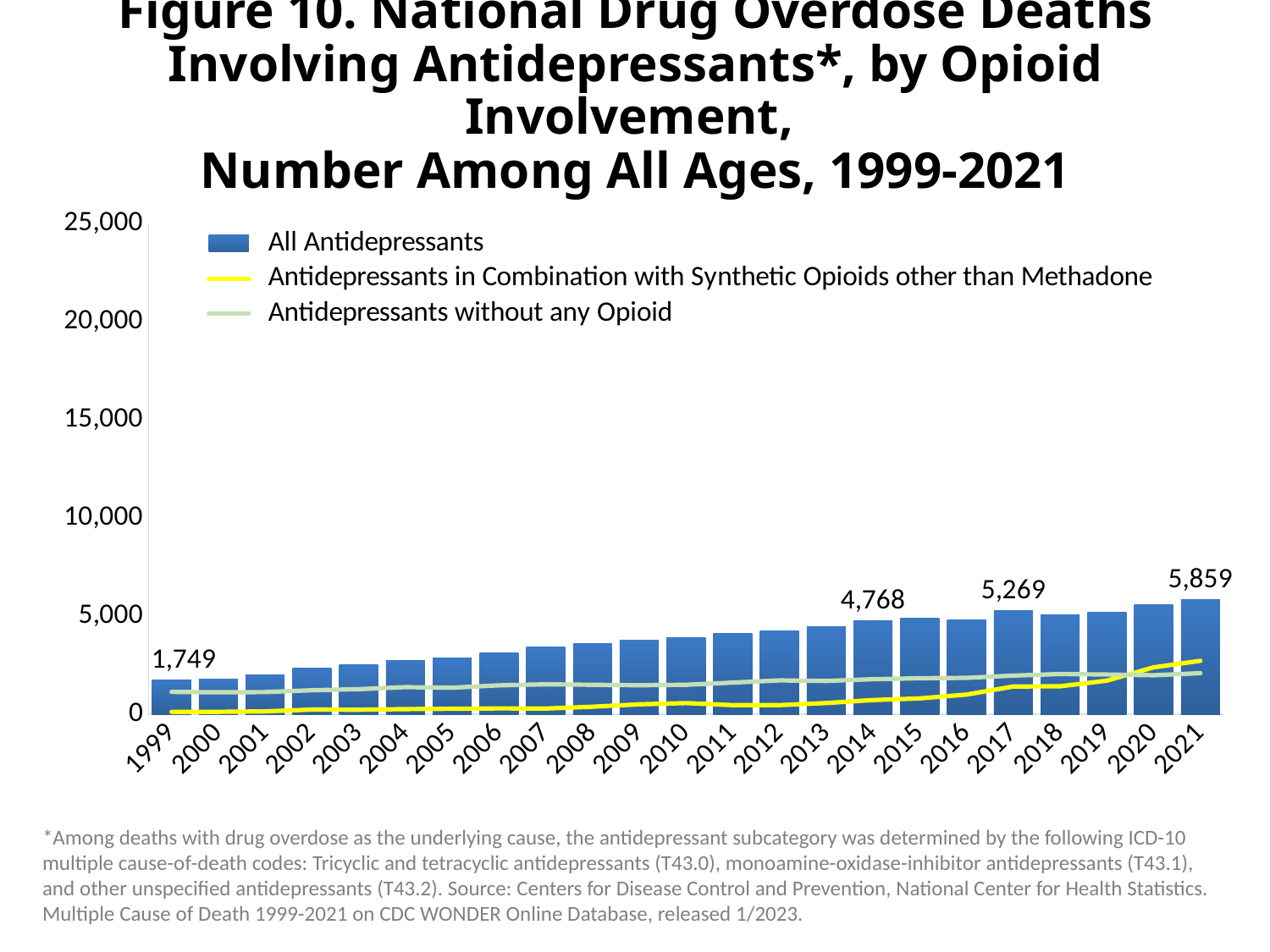
Which year has the lowest value for All Antidepressants? 1999 What is the value for All Antidepressants in 2021? 5,859 Do the All Antidepressants values generally rise or fall from 1999 to 2021? rise What is the difference between the All Antidepressants values in 2017 and 2014? 501 What is the difference between the All Antidepressants values in 2021 and 1999? 4,110 Which year has the highest value for All Antidepressants? 2021 What is the value for All Antidepressants in 2017? 5,269 Is the value for All Antidepressants in 2010 greater or less than 5,000? less How many years are shown on the x axis? 23 How many series does the legend list? 3 What is the value for All Antidepressants in 1999? 1,749 What is the value for All Antidepressants in 2014? 4,768